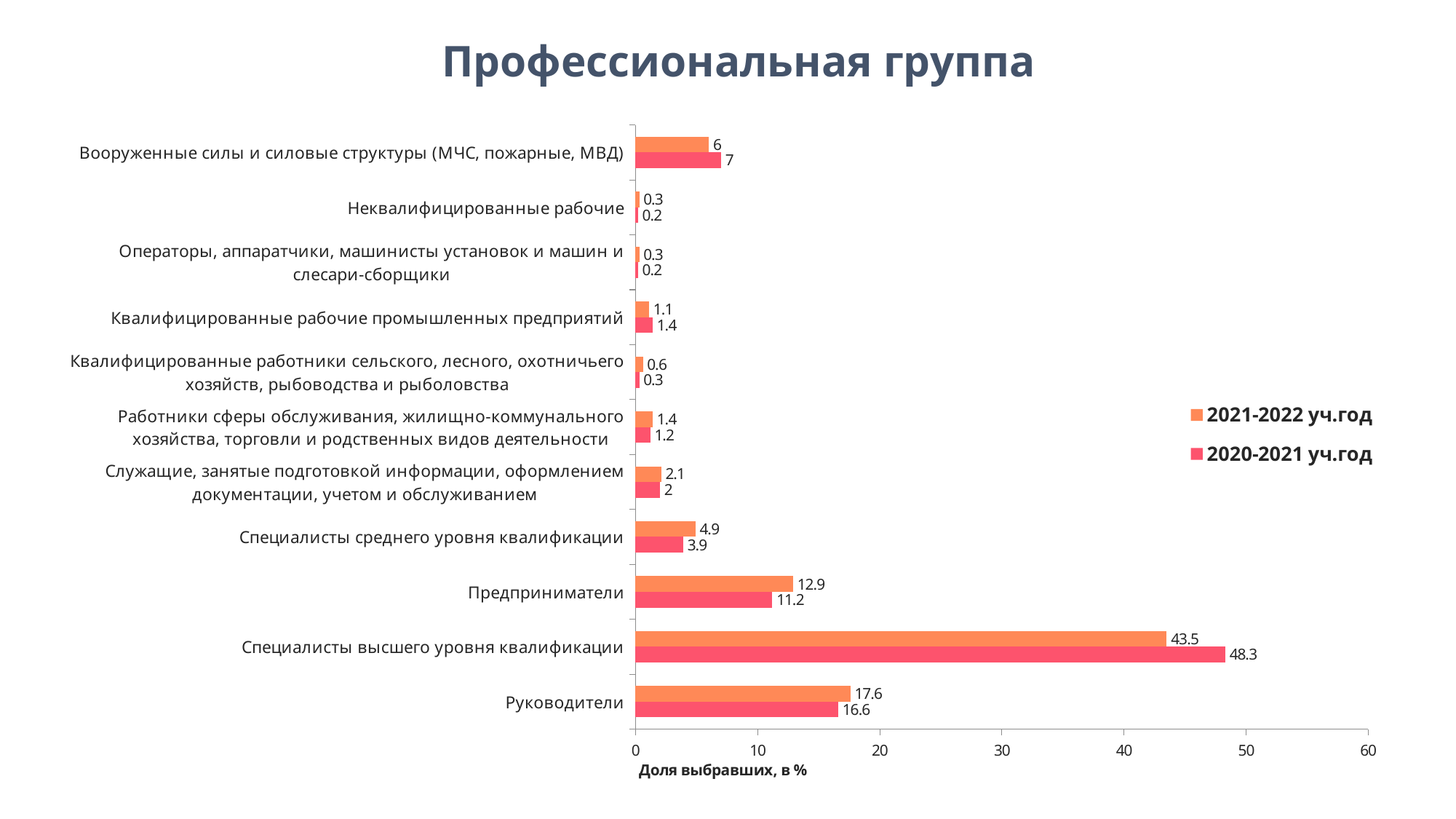
Which is larger for Специалисты среднего уровня квалификации: the 2021-2022 уч.год value or the 2020-2021 уч.год value? 2021-2022 уч.год What is the difference between the 2020-2021 уч.год and 2021-2022 уч.год values for Специалисты высшего уровня квалификации? 4.8 What is the value for Специалисты высшего уровня квалификации in the 2020-2021 уч.год series? 48.3 What kind of chart is shown on the slide? bar chart What is the title of the chart? Профессиональная группа How many series does the legend list? 2 What is the value for Руководители in the 2021-2022 уч.год series? 17.6 How many professional groups (categories) are shown on the chart? 11 What is the difference between the 2021-2022 уч.год and 2020-2021 уч.год values for Предприниматели? 1.7 Is the 2021-2022 уч.год value for Специалисты высшего уровня квалификации greater or less than 40? greater What is the value for Предприниматели in the 2020-2021 уч.год series? 11.2 Which category has the highest value in the 2021-2022 уч.год series? Специалисты высшего уровня квалификации